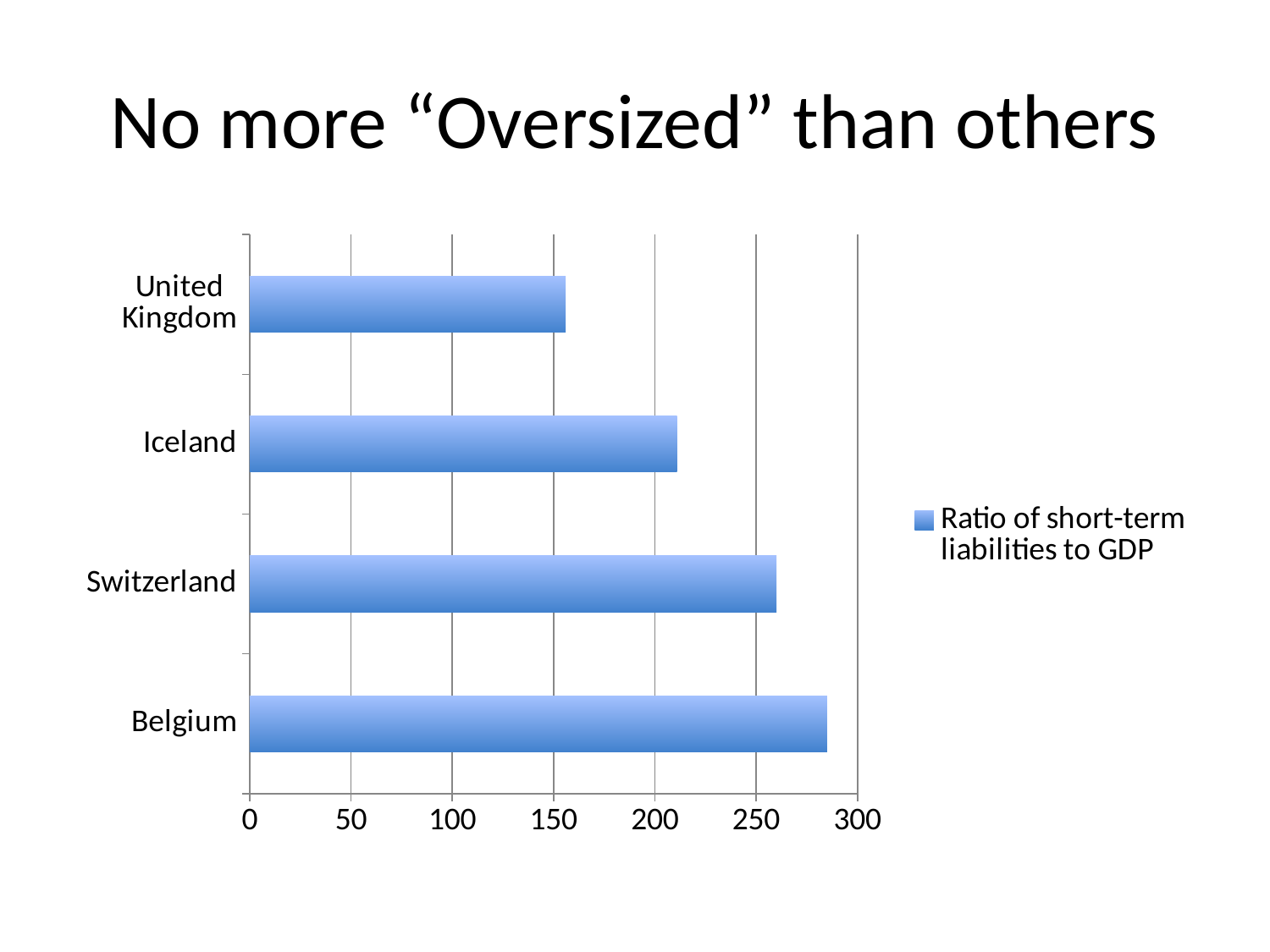
Is the value for Belgium greater or less than 250? greater Which country has the highest ratio of short-term liabilities to GDP? Belgium Is the value for Switzerland greater or less than 250? greater What is the series name shown in the legend? Ratio of short-term liabilities to GDP Which has a larger ratio of short-term liabilities to GDP, Iceland or Switzerland? Switzerland Which country has the lowest ratio of short-term liabilities to GDP? United Kingdom Is the value for Belgium greater or less than 300? less What kind of chart is shown on the slide? bar chart How many countries are shown in the chart? 4 How many series does the legend list? 1